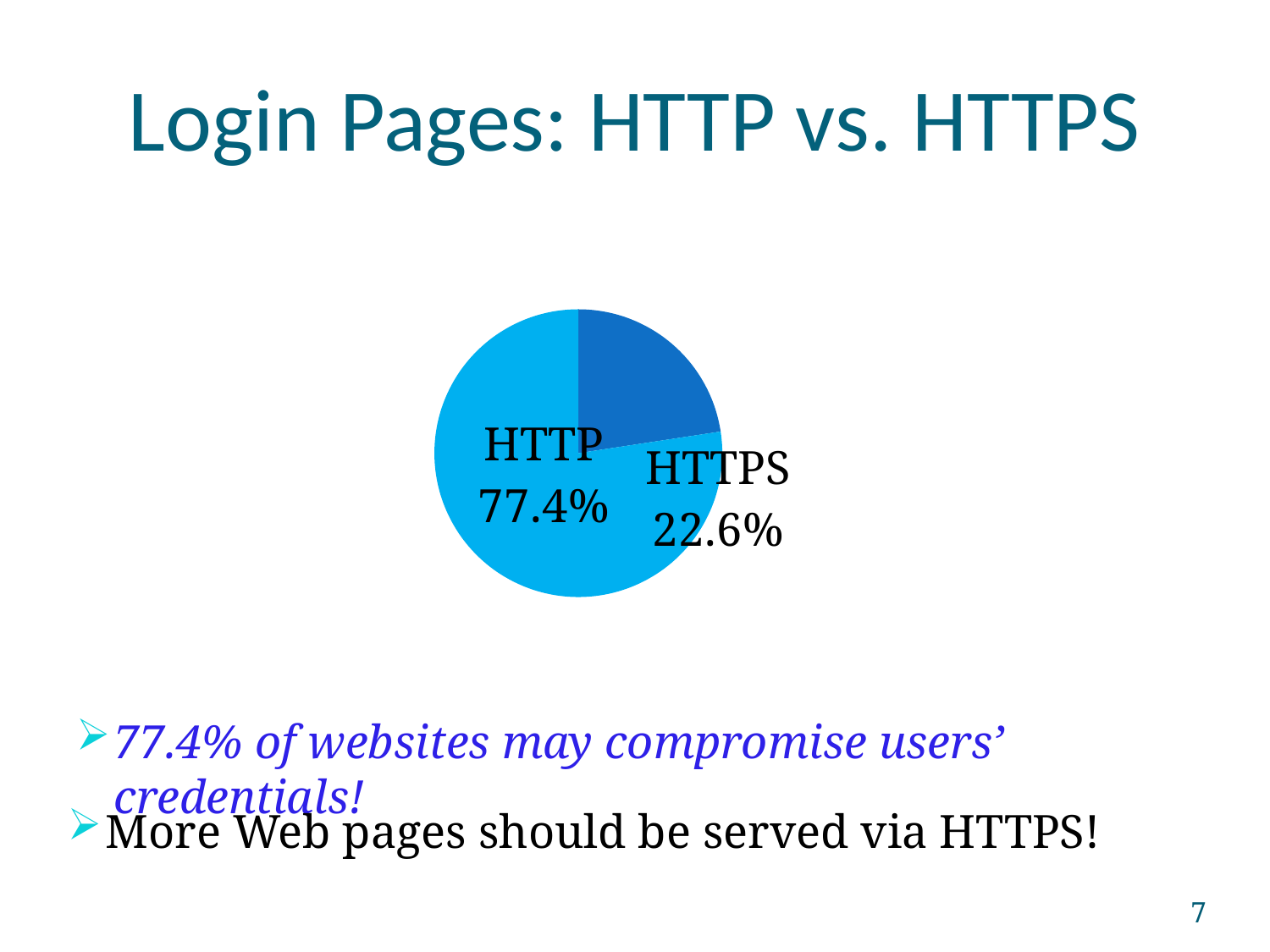
Which slice is drawn in the darker blue colour? HTTPS Is the HTTPS share greater or less than 25%? less Which slice of the pie is the smallest? HTTPS Which slice of the pie is the largest? HTTP What share of login pages is served via HTTP? 77.4% Which is larger, the HTTP slice or the HTTPS slice? HTTP What is the title of the slide containing the pie chart? Login Pages: HTTP vs. HTTPS How many slices does the pie chart have? 2 What share of login pages is served via HTTPS? 22.6% What kind of chart is shown on the slide? pie chart What is the difference in percentage points between the HTTP and HTTPS slices? 54.8 Is the HTTP share greater or less than 75%? greater